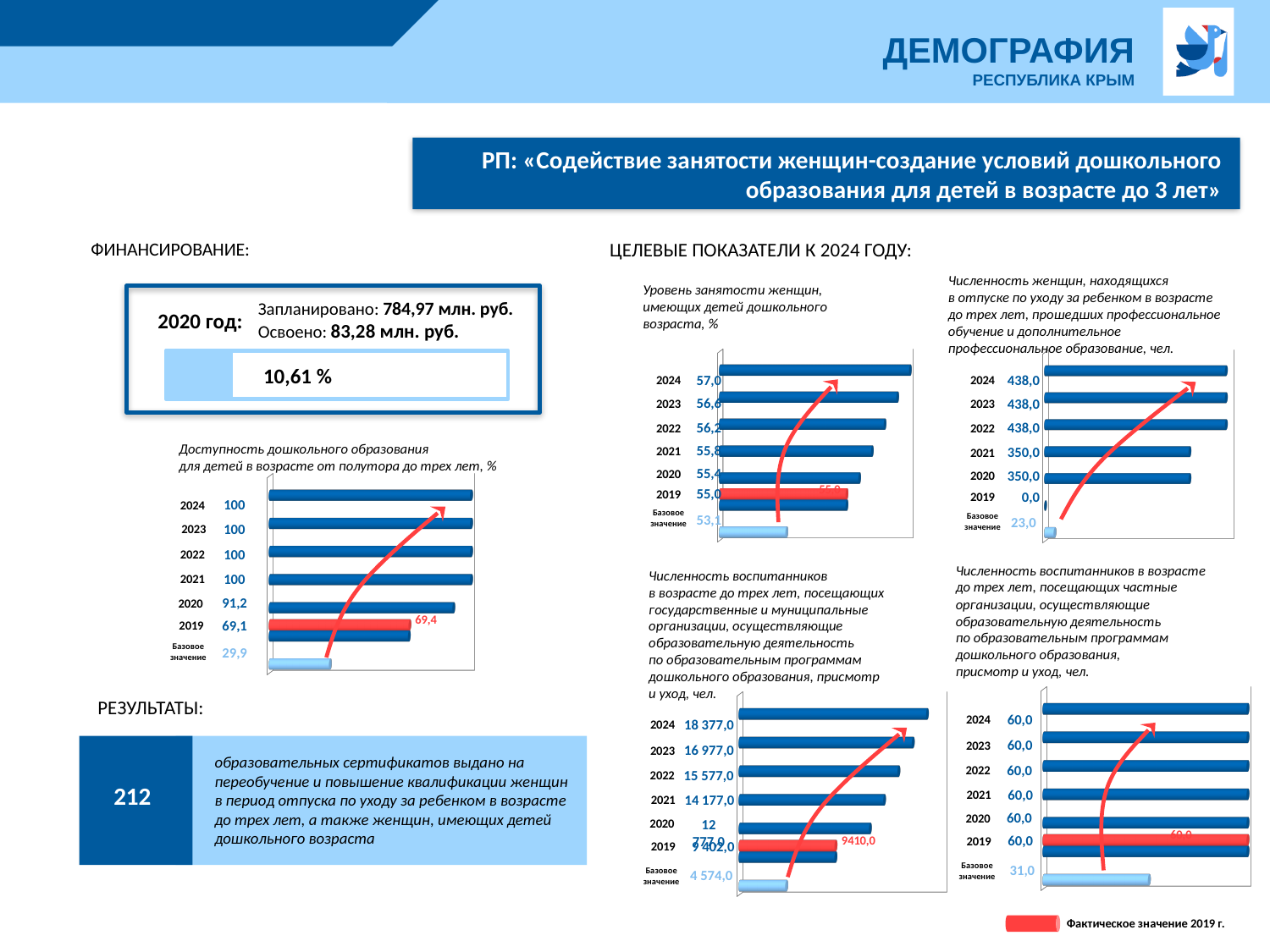
What type of chart is used for 'Доступность дошкольного образования для детей в возрасте от полутора до трех лет, %'? bar chart On the chart 'Уровень занятости женщин, имеющих детей дошкольного возраста, %', do the values rise or fall from 2019 to 2024? rise On the chart 'Численность воспитанников в возрасте до трех лет, посещающих государственные и муниципальные организации...', what is the difference between the 2024 and 2023 values? 1 400,0 On the chart 'Численность женщин, находящихся в отпуске по уходу за ребенком...', which year has the lowest value? 2019 On the chart 'Уровень занятости женщин, имеющих детей дошкольного возраста, %', what is the difference between the 2024 value and the 'Базовое значение'? 3,9 On the chart 'Доступность дошкольного образования для детей в возрасте от полутора до трех лет, %', what is the value for 2020? 91,2 On the chart 'Численность воспитанников в возрасте до трех лет, посещающих частные организации...', which is larger: the value for 2024 or the 'Базовое значение'? 2024 On the chart 'Численность воспитанников в возрасте до трех лет, посещающих государственные и муниципальные организации...', what is the value for 2023? 16 977,0 On the chart 'Численность женщин, находящихся в отпуске по уходу за ребенком...', what is the value for 2021? 350,0 On the chart 'Уровень занятости женщин, имеющих детей дошкольного возраста, %', what is the value for 2022? 56,2 On the chart 'Доступность дошкольного образования для детей в возрасте от полутора до трех лет, %', what is the 'Базовое значение'? 29,9 On the chart 'Численность воспитанников в возрасте до трех лет, посещающих частные организации...', what is the 'Базовое значение'? 31,0